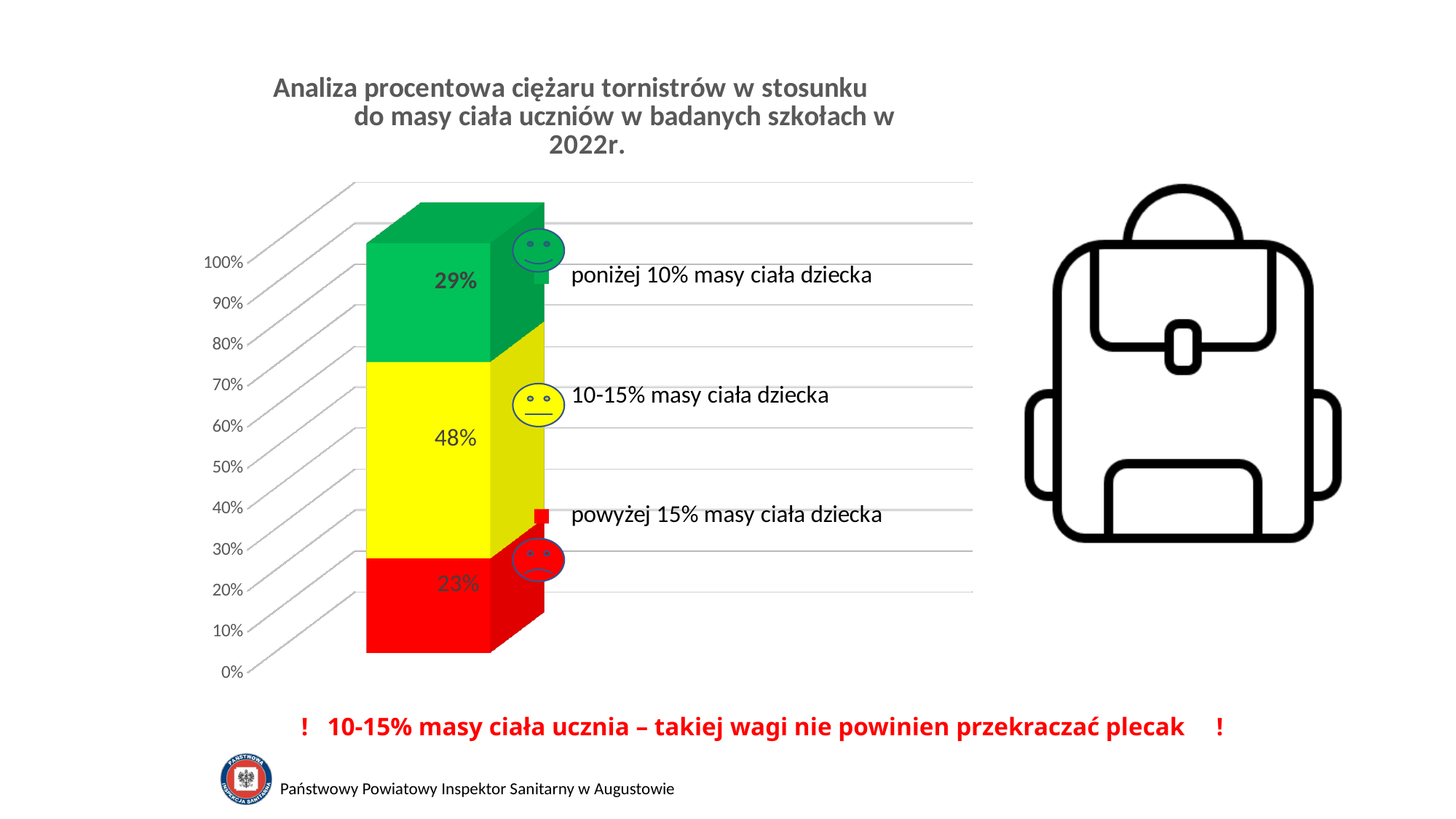
How many entries does the legend list? 3 What kind of chart is shown on the slide? Stacked bar chart What percentage of students have a school bag weighing below 10% of their body mass (poniżej 10% masy ciała dziecka)? 29% Which is larger: the share for 'poniżej 10% masy ciała dziecka' or the share for 'powyżej 15% masy ciała dziecka'? poniżej 10% masy ciała dziecka Which category has the smallest share in the stacked bar? powyżej 15% masy ciała dziecka What colour is the segment for 'powyżej 15% masy ciała dziecka'? Red Which category has the largest share in the stacked bar? 10-15% masy ciała dziecka What percentage is shown for the segment '10-15% masy ciała dziecka'? 48% What is the difference in percentage points between the '10-15% masy ciała dziecka' segment and the 'poniżej 10% masy ciała dziecka' segment? 19 What is the total of the three segments in the stacked bar? 100% How many segments make up the stacked bar? 3 What percentage is shown for the segment 'powyżej 15% masy ciała dziecka'? 23%